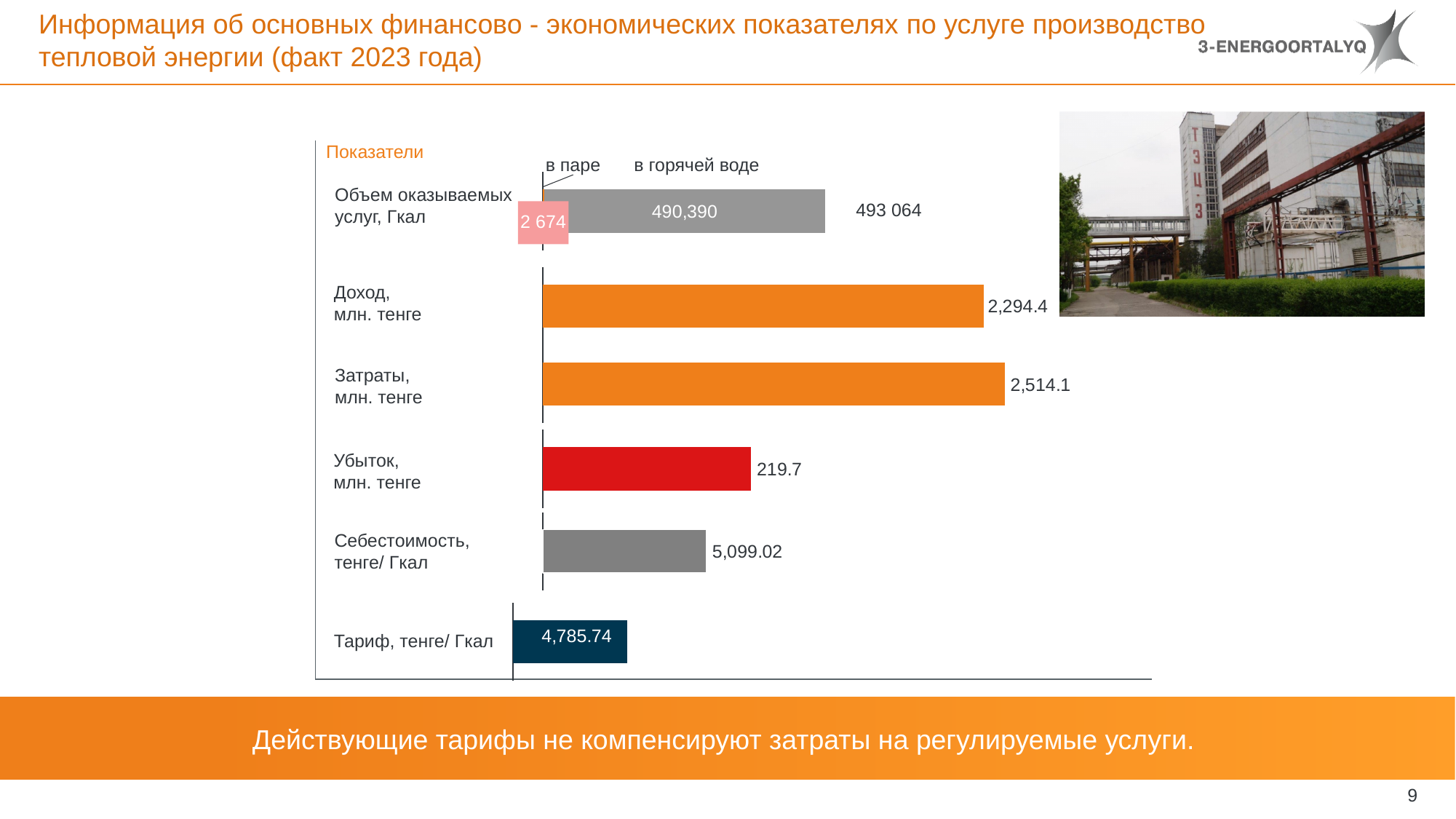
What is the value for Убыток, млн. тенге? 219.7 What is the volume of services provided in steam (в паре), Гкал? 2 674 What is the difference between Затраты and Доход, in млн. тенге? 219.7 What is the difference between Себестоимость and Тариф, in тенге/ Гкал? 313.28 What is the value for Доход, млн. тенге? 2,294.4 What is the value for Затраты, млн. тенге? 2,514.1 What kind of chart is shown on the slide? Bar chart What is the value for Тариф, тенге/ Гкал? 4,785.74 What is the total volume of services provided (Объем оказываемых услуг), Гкал, combining steam and hot water? 493 064 Which is larger, Себестоимость or Тариф (тенге/ Гкал)? Себестоимость What is the value for Себестоимость, тенге/ Гкал? 5,099.02 What is the volume of services provided in hot water (в горячей воде), Гкал? 490,390